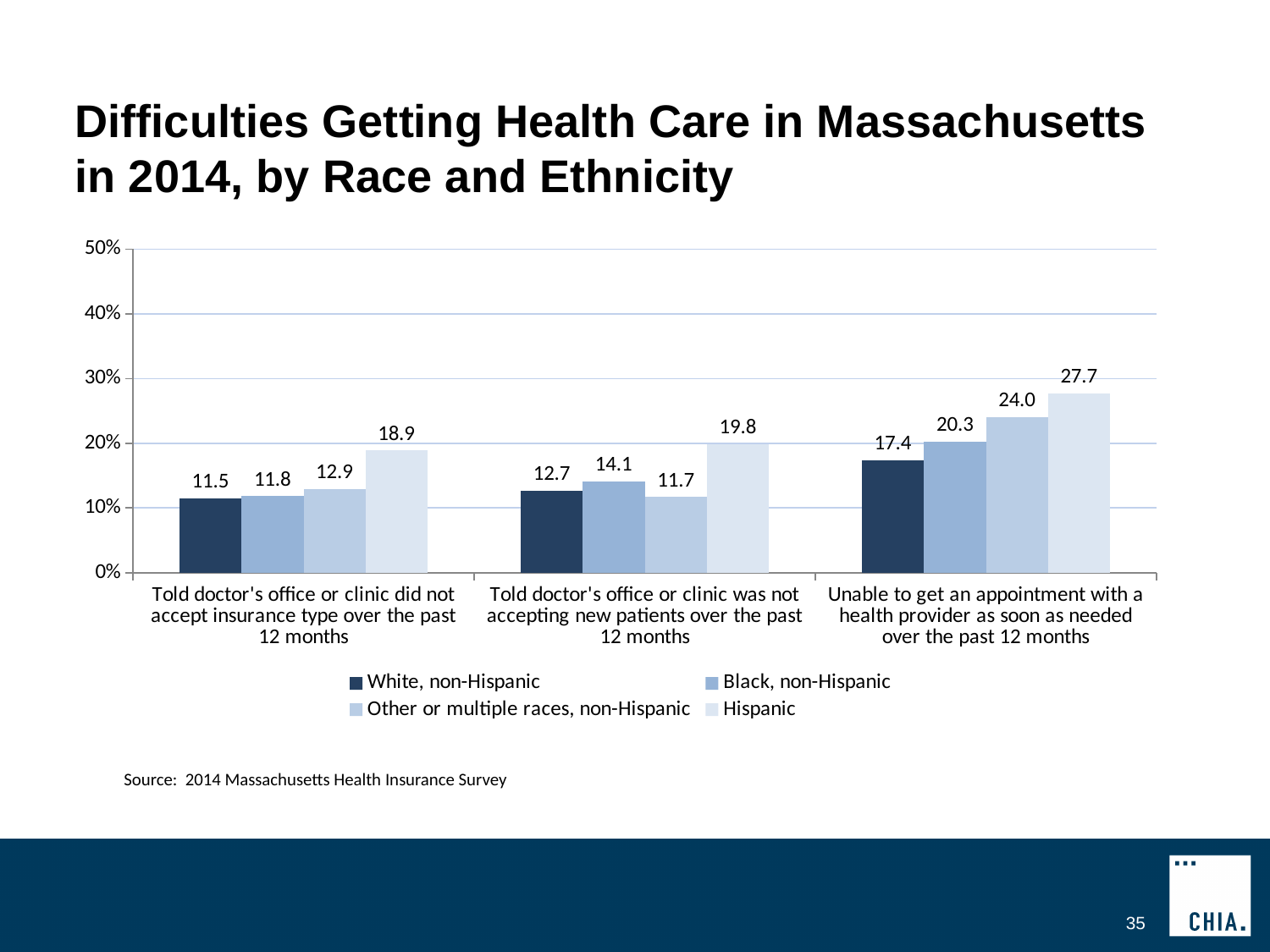
What is the value for Black, non-Hispanic in the 'Told doctor's office or clinic was not accepting new patients over the past 12 months' category? 14.1 How many series does the legend list? 4 What is the source cited below the chart? 2014 Massachusetts Health Insurance Survey What is the value for Hispanic in the 'Unable to get an appointment with a health provider as soon as needed over the past 12 months' category? 27.7 What kind of chart is shown on the slide? Bar chart What is the difference between the Hispanic and White, non-Hispanic values in the 'Unable to get an appointment with a health provider as soon as needed over the past 12 months' category? 10.3 Which is larger: the Hispanic value for 'Told doctor's office or clinic did not accept insurance type' or the Hispanic value for 'Told doctor's office or clinic was not accepting new patients'? Told doctor's office or clinic was not accepting new patients Which series has the highest value in the 'Unable to get an appointment with a health provider as soon as needed over the past 12 months' category? Hispanic What is the value for White, non-Hispanic in the 'Told doctor's office or clinic did not accept insurance type over the past 12 months' category? 11.5 Is the value for Other or multiple races, non-Hispanic in the 'Unable to get an appointment with a health provider as soon as needed' category greater or less than 20%? greater How many categories are shown on the x axis? 3 Which series has the lowest value in the 'Told doctor's office or clinic was not accepting new patients over the past 12 months' category? Other or multiple races, non-Hispanic